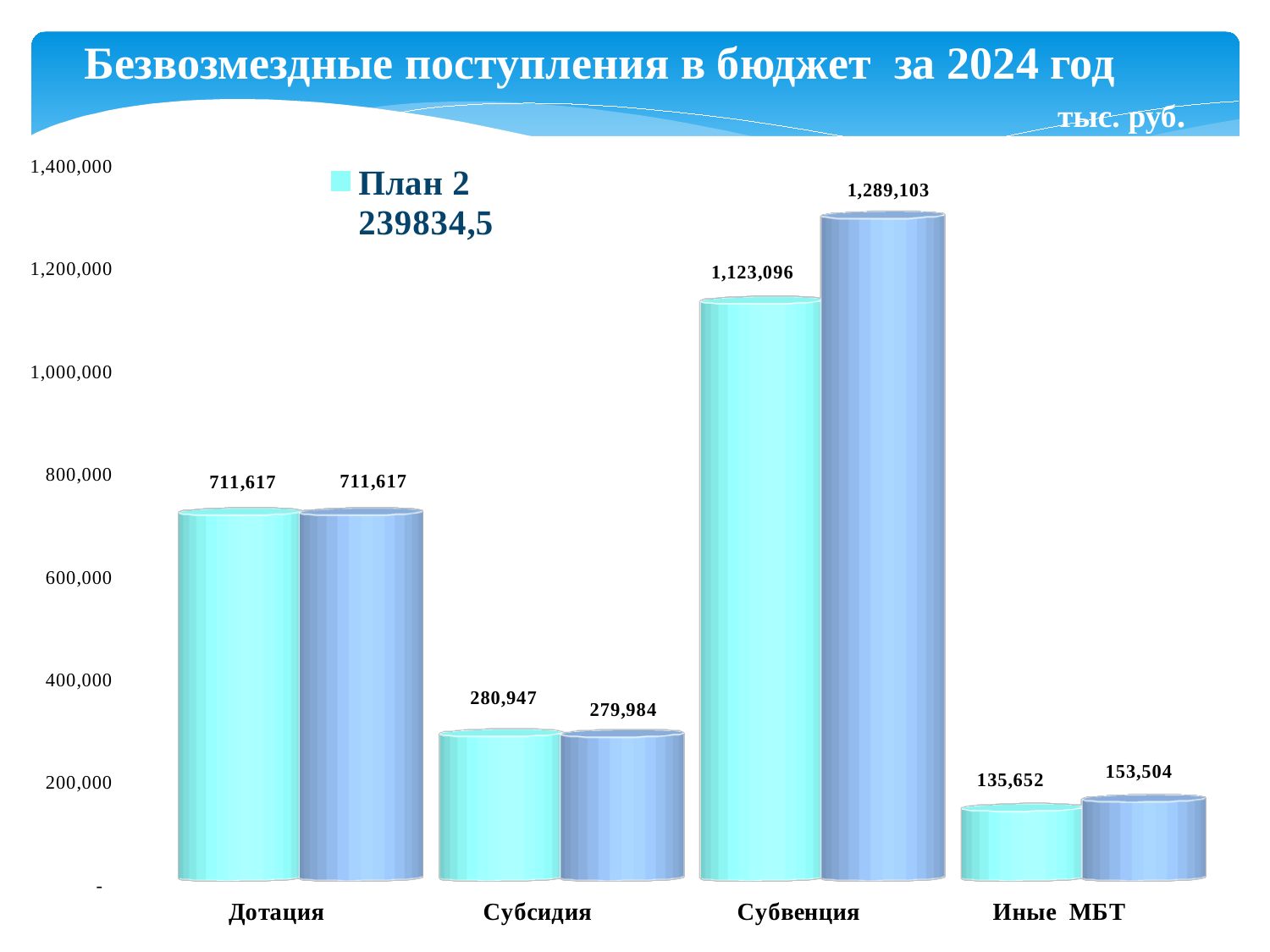
What is the value of the light cyan (first) bar for Субвенция? 1,123,096 Which category has the lowest values in the chart? Иные МБТ For Иные МБТ, which bar is larger: the light cyan (first) bar or the blue (second) bar? the blue (second) bar What is the value of the blue (second) bar for Субвенция? 1,289,103 Which category has the highest values in the chart? Субвенция What unit is stated in the top right corner of the slide? тыс. руб. What is the value of the blue (second) bar for Иные МБТ? 153,504 What is the value of the light cyan (first) bar for Дотация? 711,617 What is the difference between the blue bar and the light cyan bar for Субвенция? 166,007 How many categories are shown on the x axis of the chart? 4 Is the value of the light cyan bar for Субсидия greater or less than 400,000? less What type of chart is shown on the slide? bar chart